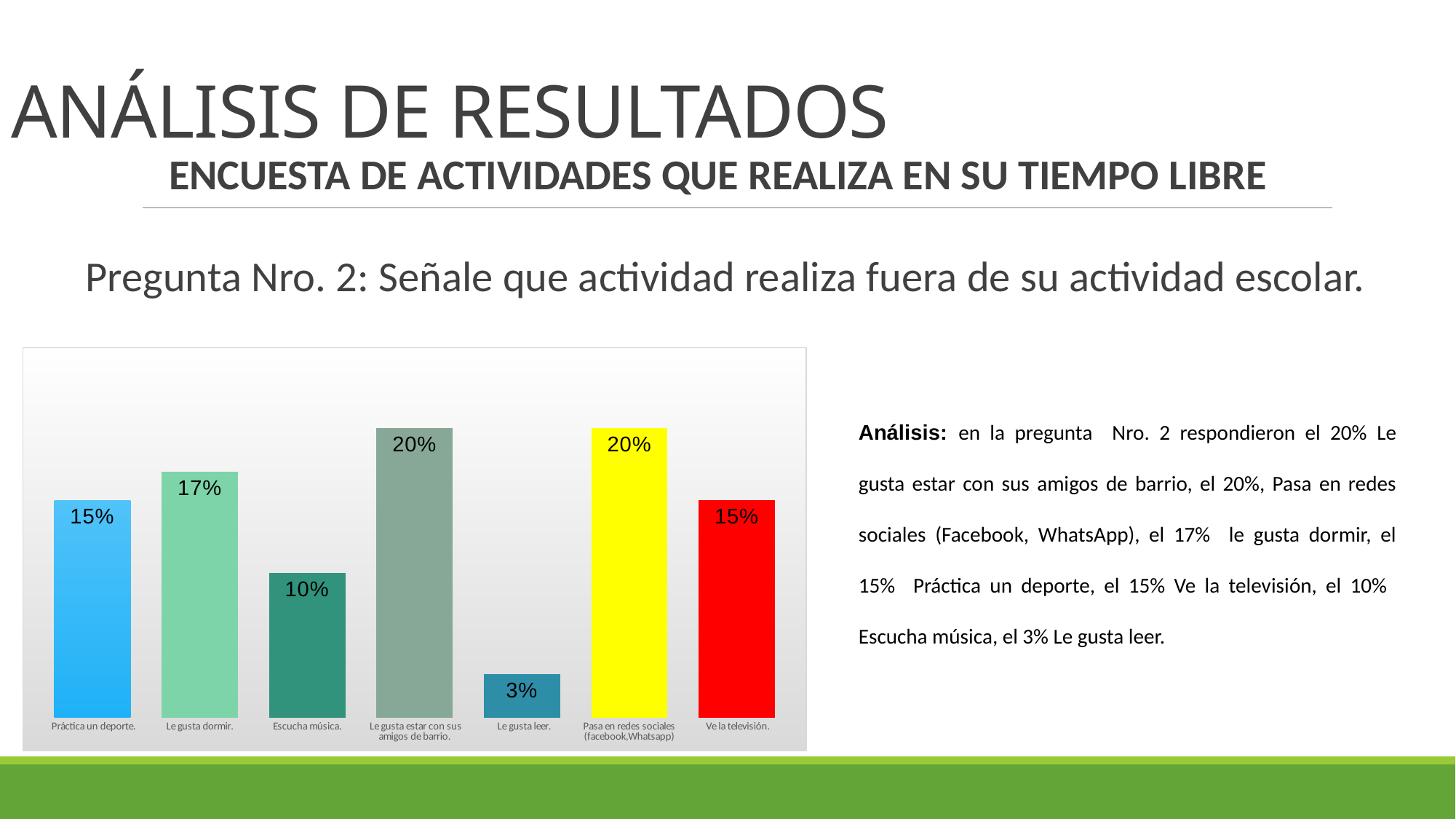
How many categories are shown in the chart? 7 What is the value for "Escucha música."? 10% What is the value for "Ve la televisión."? 15% What kind of chart is shown on the slide? Bar chart What is the value for "Le gusta leer."? 3% What is the difference between "Le gusta estar con sus amigos de barrio." and "Le gusta leer."? 17% Which is larger, "Le gusta dormir." or "Práctica un deporte."? Le gusta dormir. Which category has the lowest value? Le gusta leer. Which is larger, "Escucha música." or "Ve la televisión."? Ve la televisión. What is the difference between "Le gusta dormir." and "Escucha música."? 7% What colour is the bar for "Pasa en redes sociales (facebook,Whatsapp)"? Yellow What is the value for "Le gusta dormir."? 17%